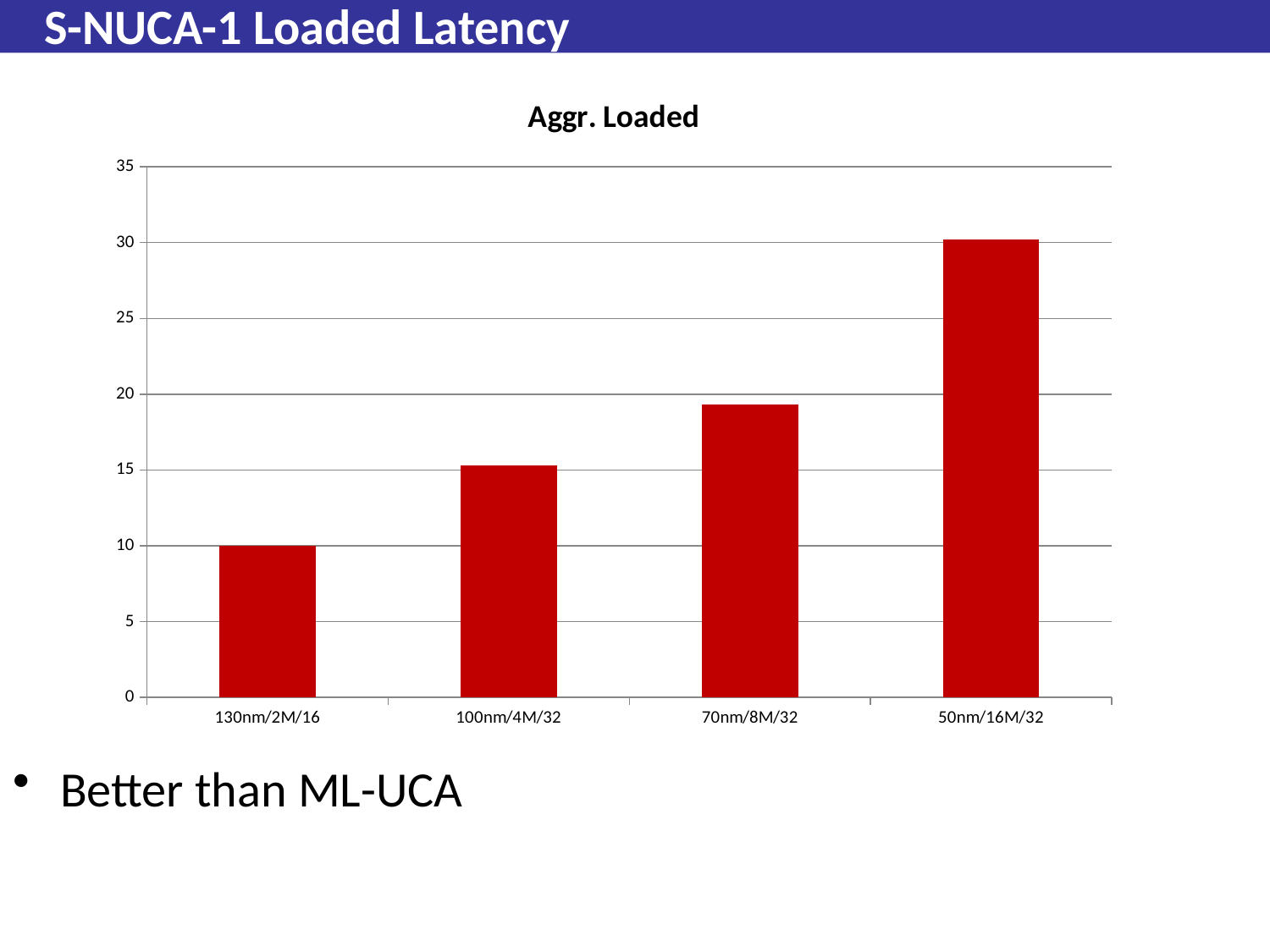
Is the value for 100nm/4M/32 greater or less than 20? less Which category has the highest value in the chart? 50nm/16M/32 Is the value for 50nm/16M/32 greater or less than 25? greater Which is larger, the value for 70nm/8M/32 or the value for 100nm/4M/32? 70nm/8M/32 What is the value for 130nm/2M/16? 10 How many categories are shown on the x axis of the chart? 4 Is the value for 70nm/8M/32 greater or less than 15? greater Which category has the lowest value in the chart? 130nm/2M/16 What colour are the bars in the chart? red What type of chart is shown on the slide? bar chart Do the values rise or fall moving left to right along the x axis? rise What is the title of the chart? Aggr. Loaded